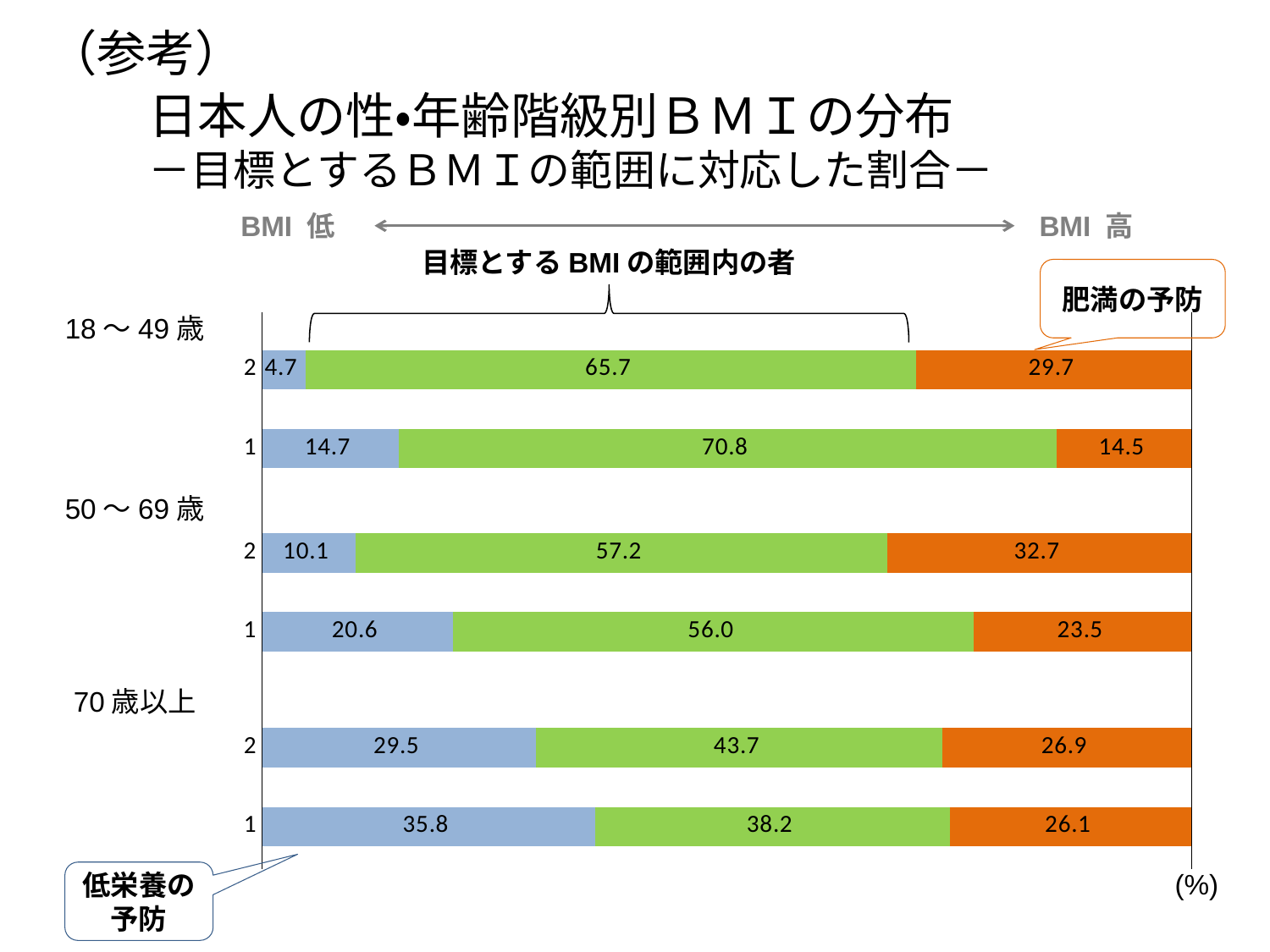
How many bars are plotted in the chart? 6 Which is larger: the orange segment for row 2 of 18～49歳 or the orange segment for row 2 of 70歳以上? 18～49歳, row 2 Looking at the green segment for row 1 across the age groups from 18～49歳 to 70歳以上, does the value rise or fall? fall What kind of chart is shown on the slide? stacked bar chart What is the value of the orange (right) segment for row 2 of the 50～69歳 group? 32.7 What unit label is printed at the bottom right of the chart? (%) Which bar has the smallest blue (left) segment? 18～49歳, row 2 What is the value of the blue (left) segment for row 1 of the 50～69歳 group? 20.6 Which bar has the largest green (middle) segment? 18～49歳, row 1 What is the value of the green (middle) segment for row 1 of the 18～49歳 group? 70.8 What is the total of the three segments for row 1 of the 18～49歳 group? 100.0 For row 1 of the 70歳以上 group, what is the difference between the green segment and the blue segment? 2.4